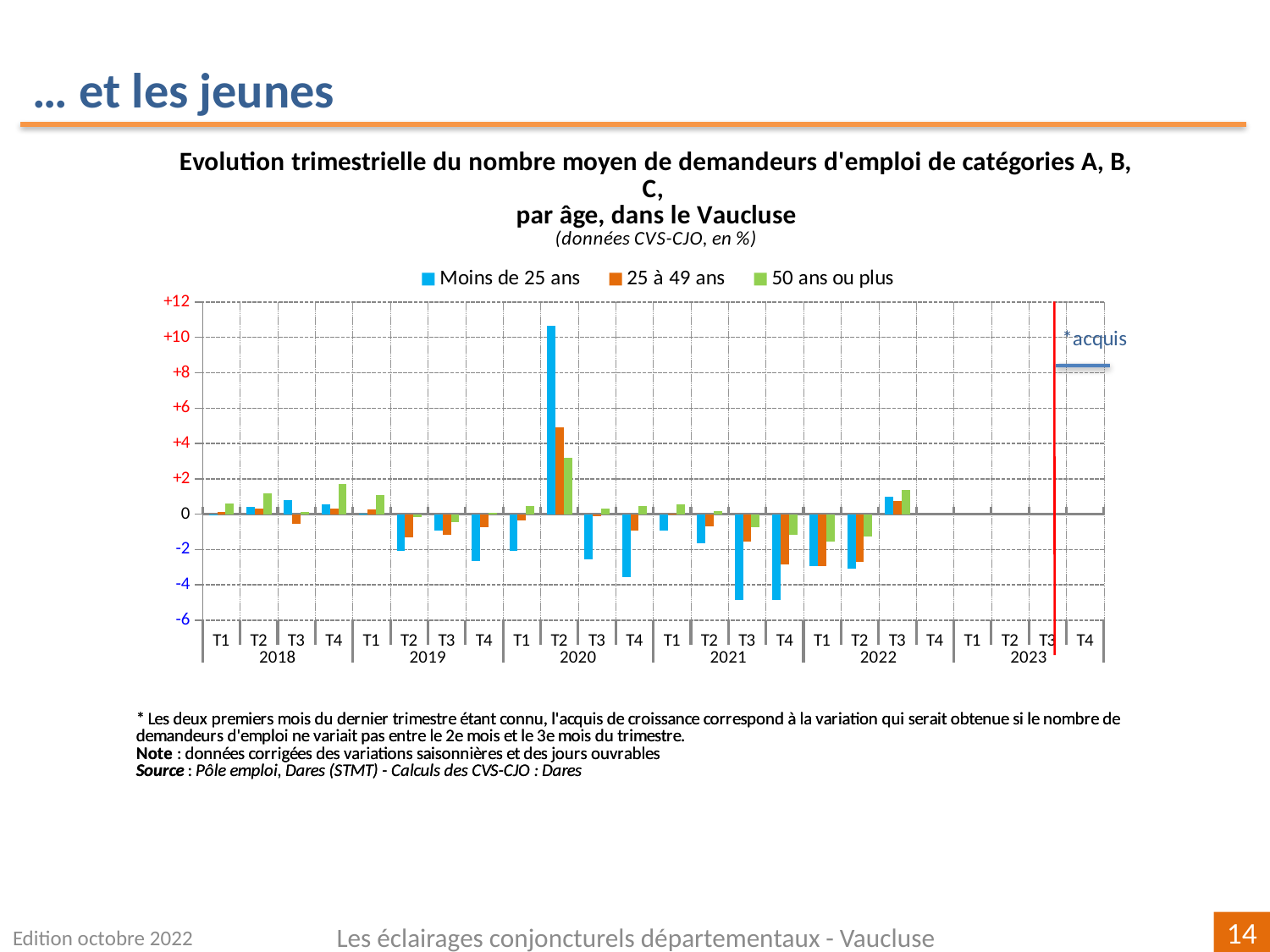
What kind of chart is shown on the slide? bar chart Is the value for 'Moins de 25 ans' in T2 2020 greater or less than +10? greater How many years are labelled along the x axis? 6 Is the value for 'Moins de 25 ans' in T1 2022 greater or less than -2? less Is the value for 'Moins de 25 ans' in T3 2021 greater or less than -4? less In T3 2021, which series has the larger value: 'Moins de 25 ans' or '25 à 49 ans'? 25 à 49 ans In which quarter does the 'Moins de 25 ans' series reach its highest value? T2 2020 In T2 2020, which series has the larger value: 'Moins de 25 ans' or '50 ans ou plus'? Moins de 25 ans How many series does the legend list? 3 What is the unit of the data according to the chart subtitle? % What are the three series named in the legend? Moins de 25 ans, 25 à 49 ans, 50 ans ou plus